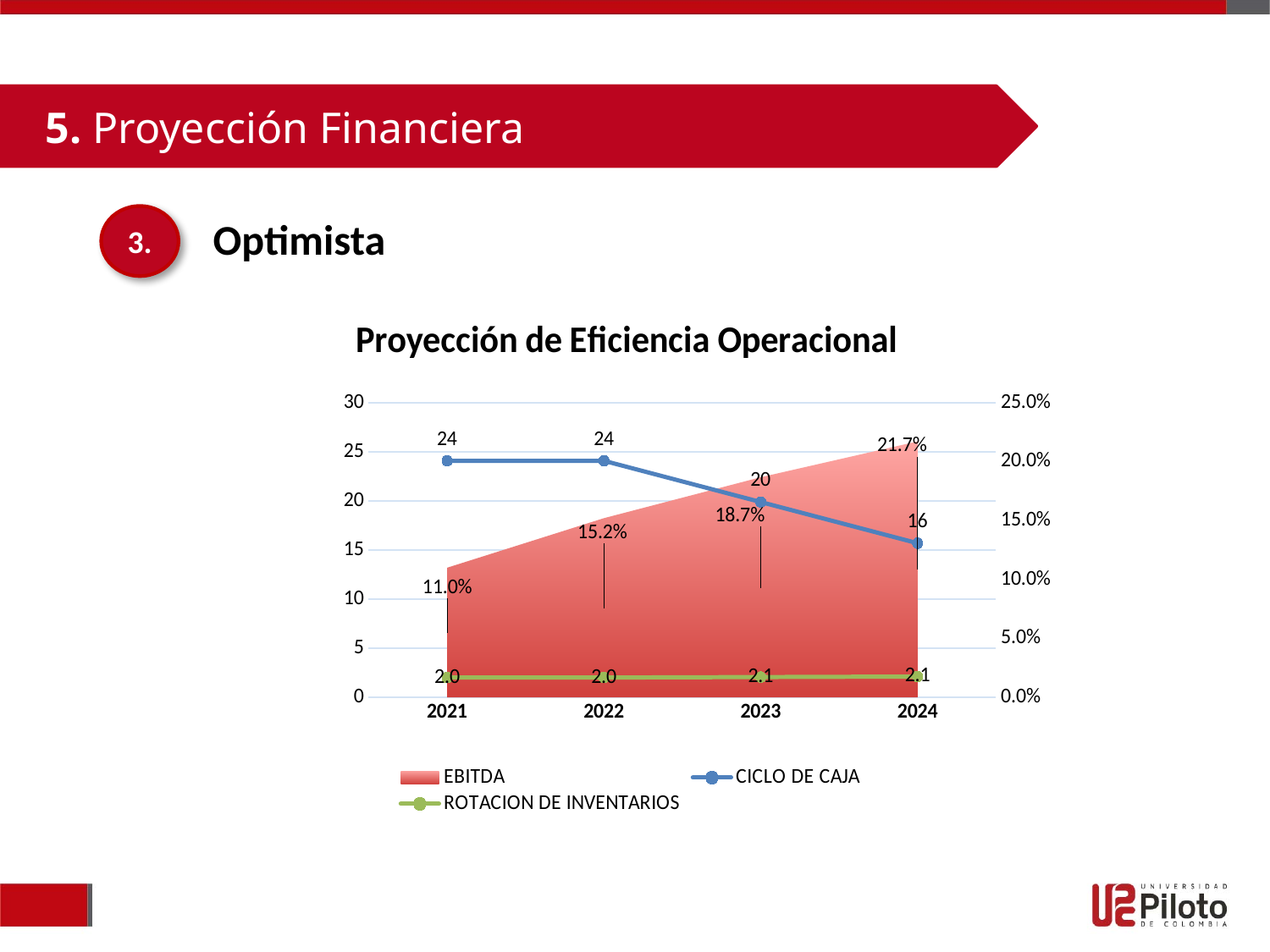
What is the CICLO DE CAJA value for 2023? 20 How does CICLO DE CAJA change from 2021 to 2024? It falls What is the title of the chart? Proyección de Eficiencia Operacional What is the ROTACION DE INVENTARIOS value for 2021? 2.0 In which year is EBITDA lowest? 2021 How many series does the legend list? 3 How many years are shown on the x axis? 4 What is the difference between the CICLO DE CAJA values for 2021 and 2024? 8 What is the EBITDA value for 2024? 21.7% What is the EBITDA value for 2022? 15.2% In which year is CICLO DE CAJA lowest? 2024 Which is larger, the EBITDA value for 2023 or for 2022? 2023